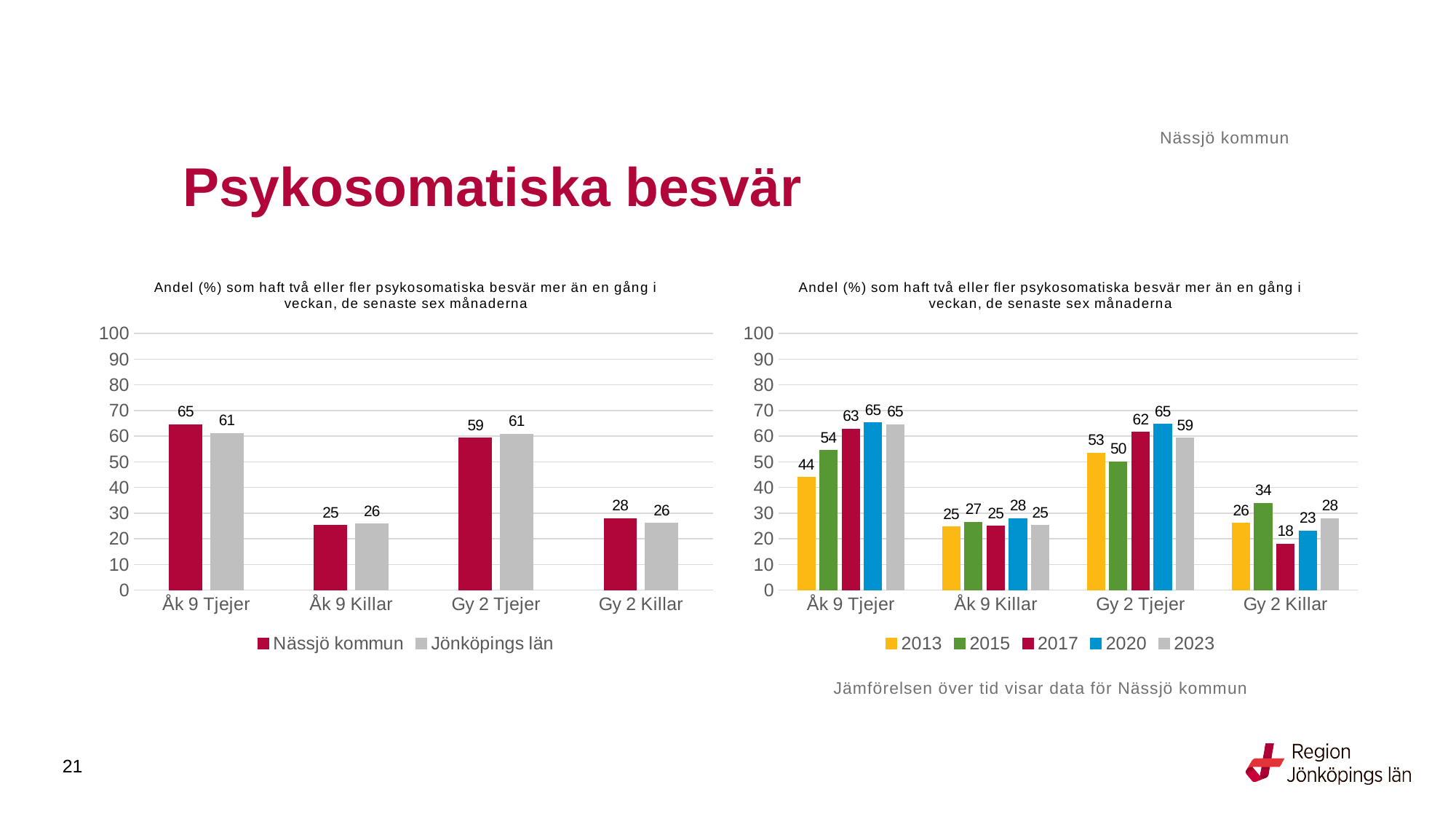
In the right chart, what is the value for 2017 for Gy 2 Killar? 18 In the left chart, which is larger for Gy 2 Tjejer: Nässjö kommun or Jönköpings län? Jönköpings län In the left chart, what is the value for Nässjö kommun for Åk 9 Tjejer? 65 In the left chart, what is the value for Jönköpings län for Gy 2 Killar? 26 In the left chart, what is the difference between Nässjö kommun and Jönköpings län for Åk 9 Tjejer? 4 In the left chart, how many series does the legend list? 2 In the right chart, how many series does the legend list? 5 What kind of chart is the right chart? Bar chart In the right chart, what is the difference between 2020 and 2013 for Åk 9 Tjejer? 21 In the right chart, what is the value for 2013 for Åk 9 Tjejer? 44 In the right chart, which year has the lowest value for Åk 9 Tjejer? 2013 In the right chart, which year has the highest value for Gy 2 Killar? 2015